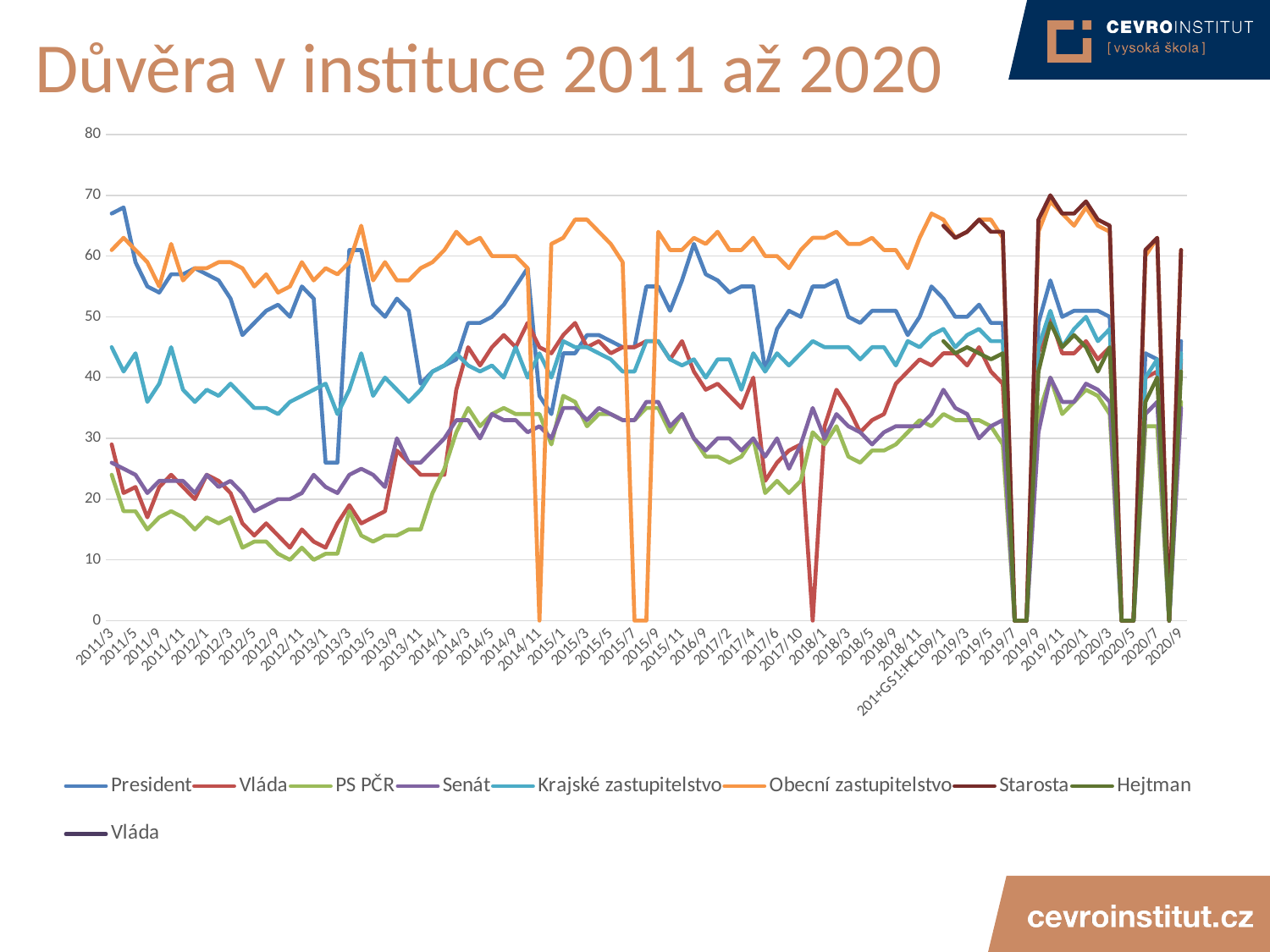
Which series has the highest value at 2011/3? President How many series does the legend list? 9 At 2011/3, which is larger: the value for Obecní zastupitelstvo or the value for Senát? Obecní zastupitelstvo What kind of chart is shown on the slide? line chart Is the value for Obecní zastupitelstvo at 2011/3 greater or less than 50? greater Is the value for Vláda at 2012/11 greater or less than 20? less Is the value for President at 2011/3 greater or less than 60? greater What is the title of the chart? Důvěra v instituce 2011 až 2020 Which legend entry appears twice in the legend? Vláda At 2011/3, which is larger: the value for President or the value for PS PČR? President Does the PS PČR series rise or fall from 2011/3 to 2012/9? fall